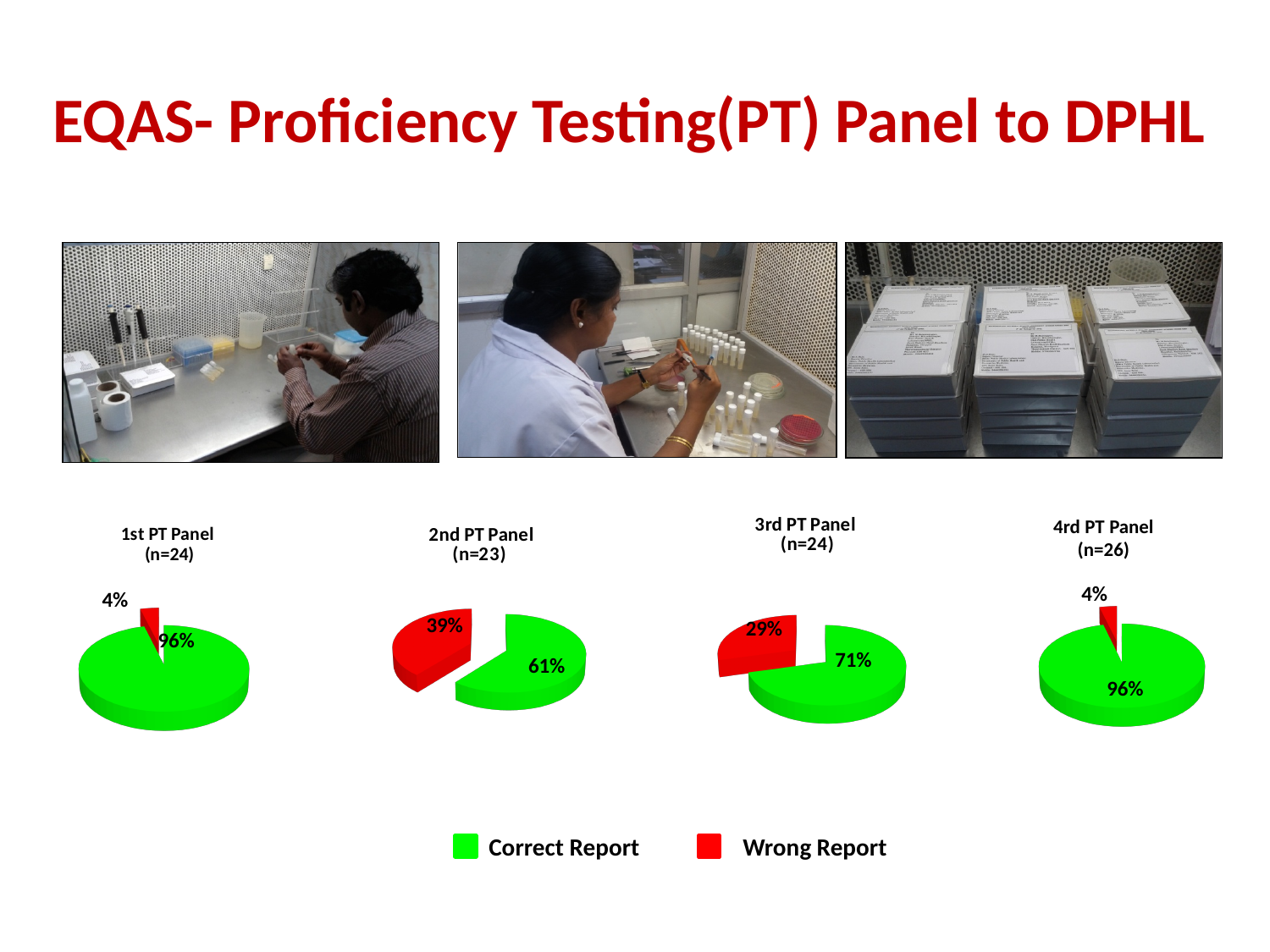
How many entries does the shared legend list? 2 In the 2nd PT Panel (n=23) chart, what percentage is shown for Wrong Report? 39% Across the four pie charts, which PT Panel has the highest Wrong Report percentage? 2nd PT Panel (n=23) In the 2nd PT Panel (n=23) chart, what is the difference between the Correct Report and Wrong Report percentages? 22% Across the four pie charts, which PT Panel has the lowest Correct Report percentage? 2nd PT Panel (n=23) In the 1st PT Panel (n=24) chart, what percentage is shown for Correct Report? 96% In the 4rd PT Panel (n=26) chart, what percentage is shown for Wrong Report? 4% How many slices does the 1st PT Panel (n=24) pie chart have? 2 Which colour represents Wrong Report in the legend? Red What kind of chart is used for the 2nd PT Panel (n=23)? Pie chart In the 3rd PT Panel (n=24) chart, what percentage is shown for Correct Report? 71% In the 3rd PT Panel (n=24) chart, which slice is larger, Correct Report or Wrong Report? Correct Report